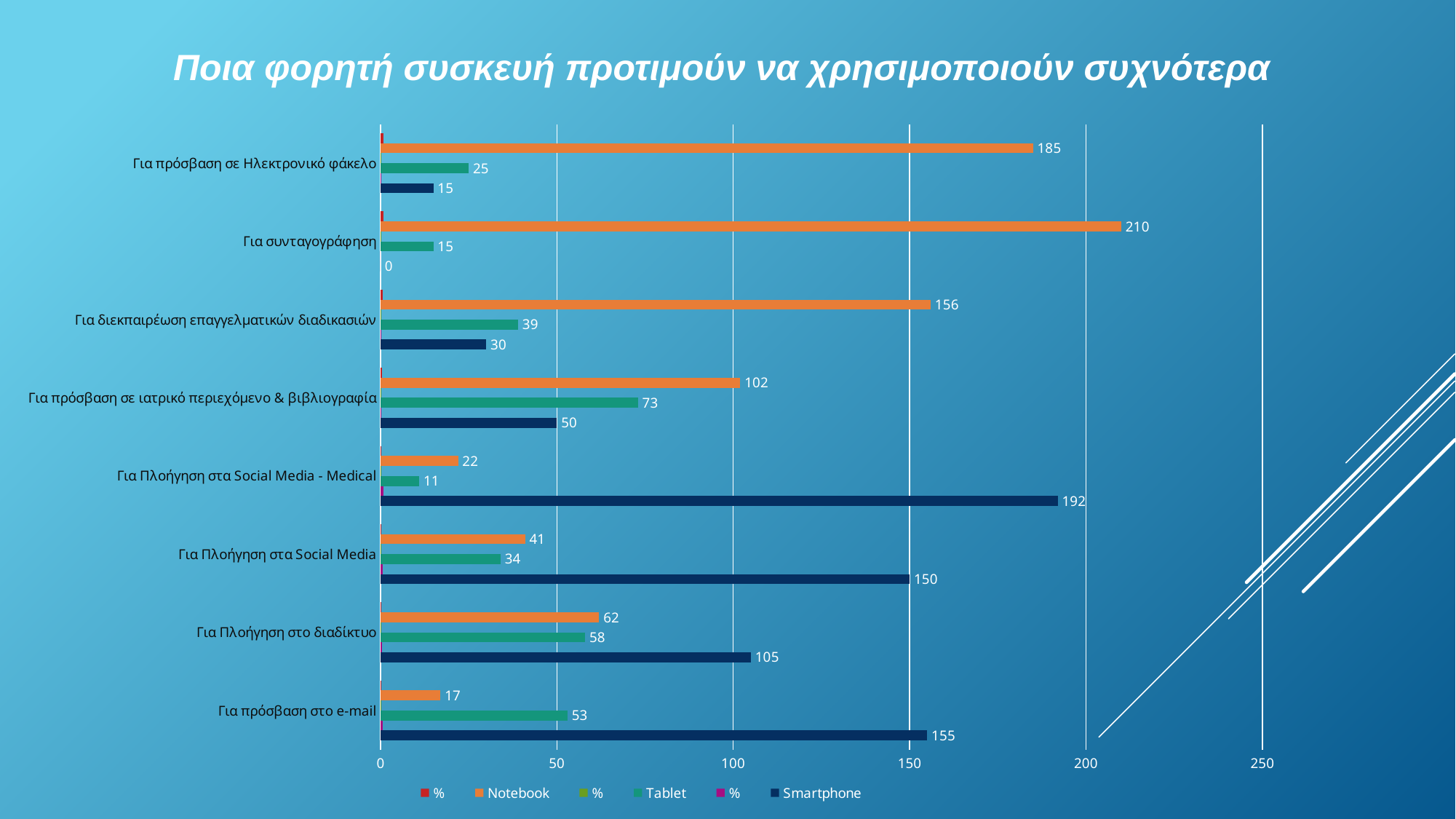
For "Για Πλοήγηση στο διαδίκτυο", which is larger: the Notebook value or the Tablet value? Notebook What is the Smartphone value for "Για Πλοήγηση στα Social Media - Medical"? 192 How many series does the legend list? 6 What is the Notebook value for "Για συνταγογράφηση"? 210 What type of chart is shown on the slide? bar chart How many categories are shown on the vertical axis? 8 Which category has the lowest Smartphone value? Για συνταγογράφηση What is the title of the chart? Ποια φορητή συσκευή προτιμούν να χρησιμοποιούν συχνότερα What is the difference between the Smartphone value and the Notebook value for "Για πρόσβαση στο e-mail"? 138 Which category has the highest Notebook value? Για συνταγογράφηση What is the Tablet value for "Για πρόσβαση σε ιατρικό περιεχόμενο & βιβλιογραφία"? 73 What is the Smartphone value for "Για Πλοήγηση στα Social Media"? 150